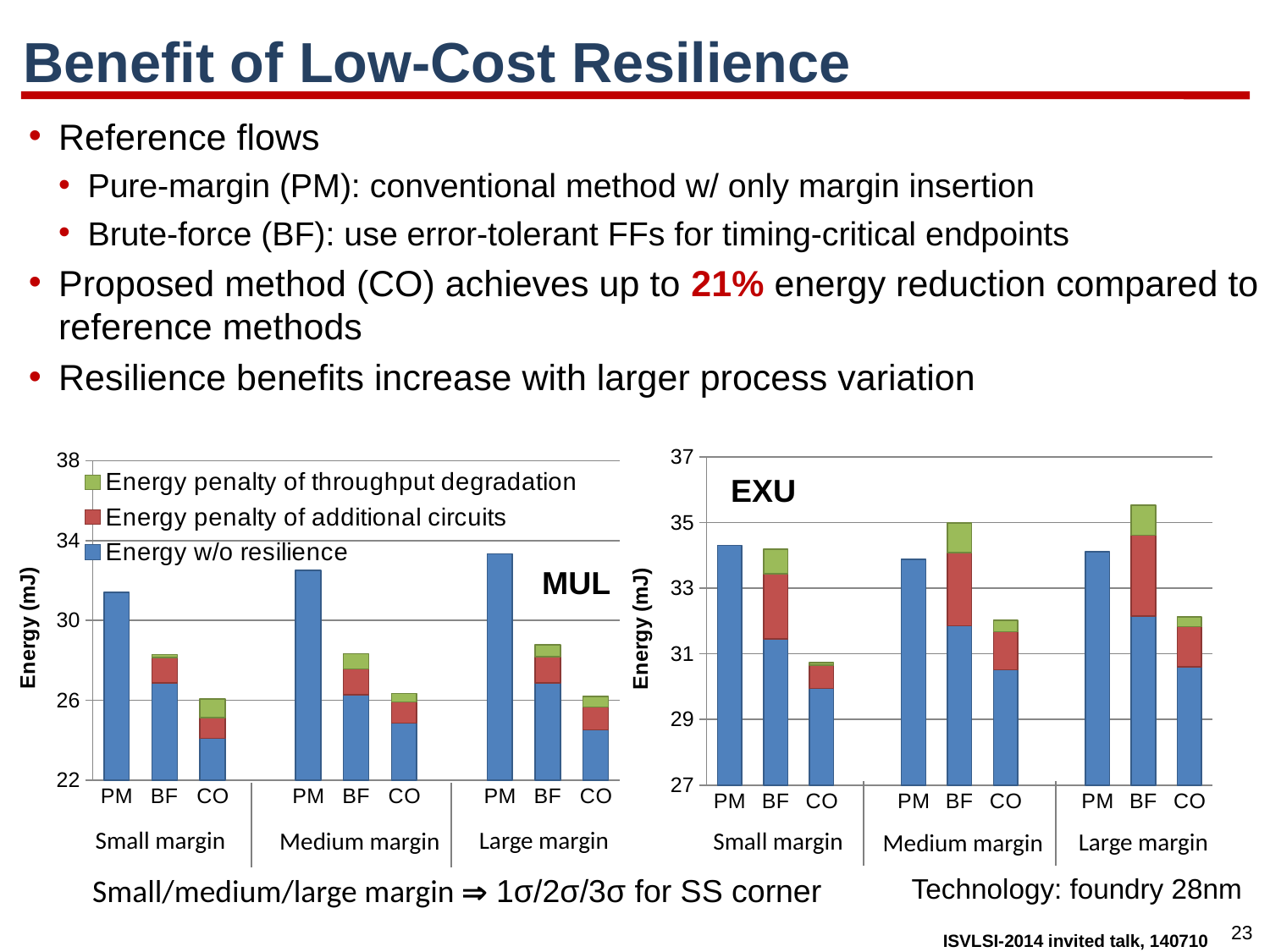
What is the y-axis label on the EXU chart? Energy (mJ) How many bars are plotted in the EXU chart? 9 In the EXU chart, which bar has the highest total energy? BF under Large margin What kind of chart is the MUL chart on the left? Stacked bar chart In the MUL chart, which is larger under Small margin: the total for PM or the total for BF? PM In the MUL chart, do the PM bars rise or fall from Small margin to Large margin? rise In the EXU chart, is the total value for CO under Small margin greater or less than 31? less In the MUL chart, is the total value for PM under Small margin greater or less than 30? greater In the EXU chart, which bar has the lowest total energy? CO under Small margin In the EXU chart, is the total value for BF under Large margin greater or less than 35? greater How many series does the legend on the MUL chart list? 3